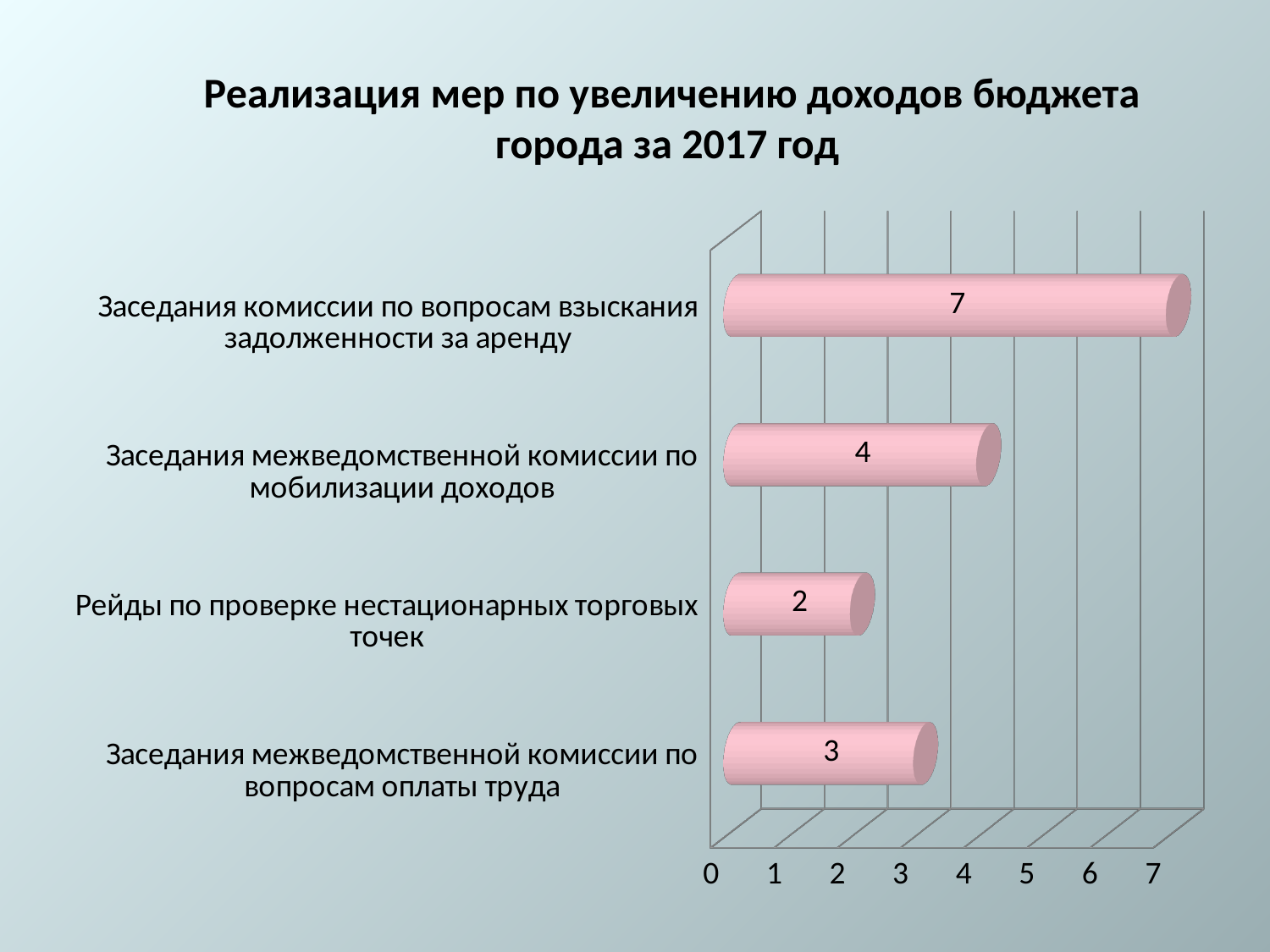
Which is larger: the value for "Заседания межведомственной комиссии по вопросам оплаты труда" or for "Рейды по проверке нестационарных торговых точек"? Заседания межведомственной комиссии по вопросам оплаты труда What kind of chart is shown on the slide? bar chart Which category has the highest value? Заседания комиссии по вопросам взыскания задолженности за аренду What is the difference between the values for "Заседания комиссии по вопросам взыскания задолженности за аренду" and "Заседания межведомственной комиссии по мобилизации доходов"? 3 What is the title of the slide? Реализация мер по увеличению доходов бюджета города за 2017 год Which category has the lowest value? Рейды по проверке нестационарных торговых точек Is the value for "Заседания межведомственной комиссии по мобилизации доходов" greater or less than 5? less What is the value for "Рейды по проверке нестационарных торговых точек"? 2 What is the value for "Заседания межведомственной комиссии по мобилизации доходов"? 4 What is the value for "Заседания комиссии по вопросам взыскания задолженности за аренду"? 7 What is the value for "Заседания межведомственной комиссии по вопросам оплаты труда"? 3 How many categories are shown in the chart? 4